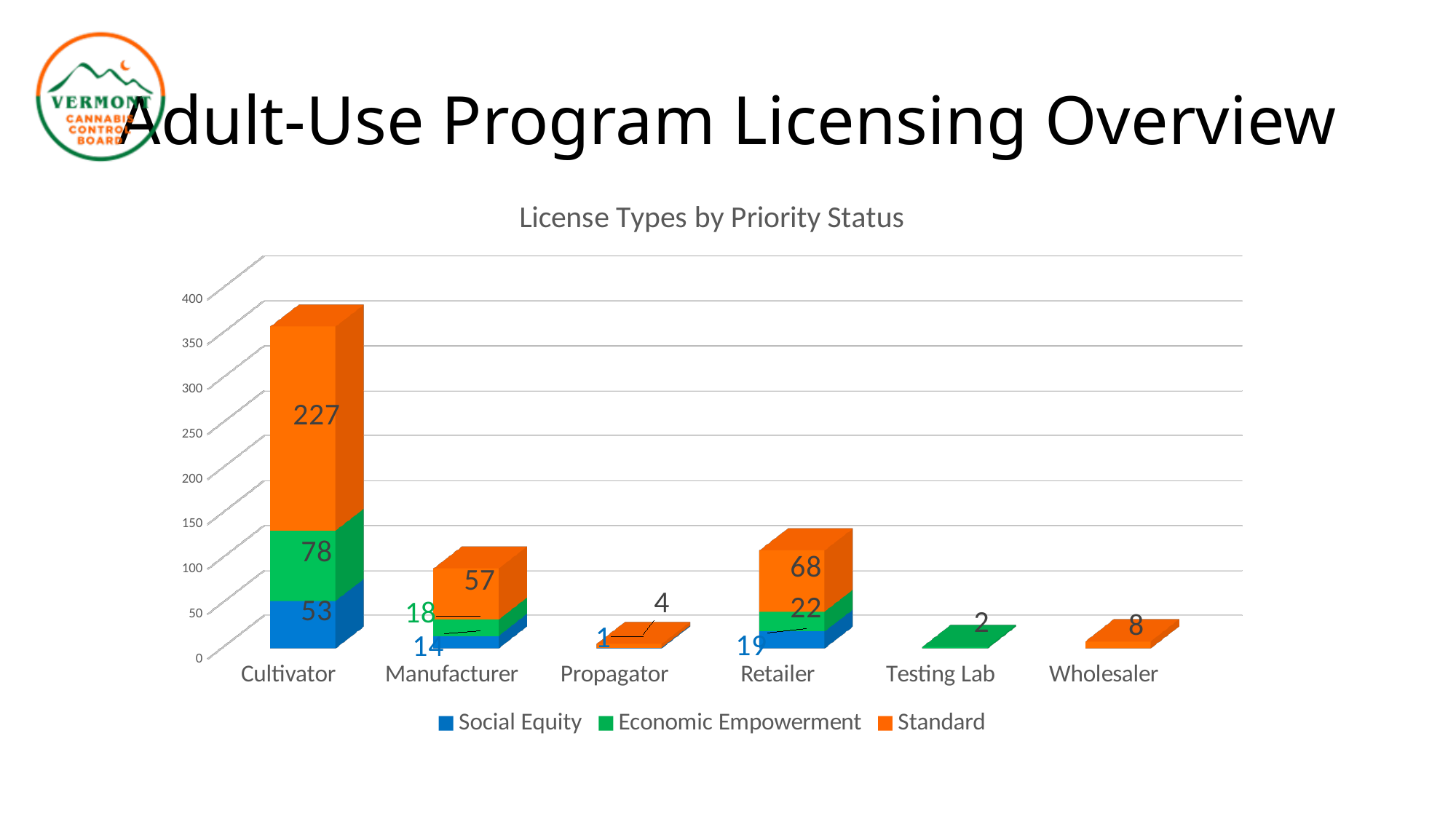
What is the Standard value for Cultivator? 227 What is the Economic Empowerment value for Manufacturer? 18 How many license type categories are shown on the x axis? 6 Which is larger, the Economic Empowerment value for Cultivator or for Retailer? Cultivator Which category has the tallest stacked bar? Cultivator What is the difference between the Standard values for Cultivator and Retailer? 159 What is the title of the chart? License Types by Priority Status What is the total of the stacked bar for Retailer? 109 What is the Social Equity value for Retailer? 19 Is the total stacked bar for Cultivator greater or less than 300? greater How many series does the legend list? 3 What kind of chart is shown on the slide? Stacked bar chart